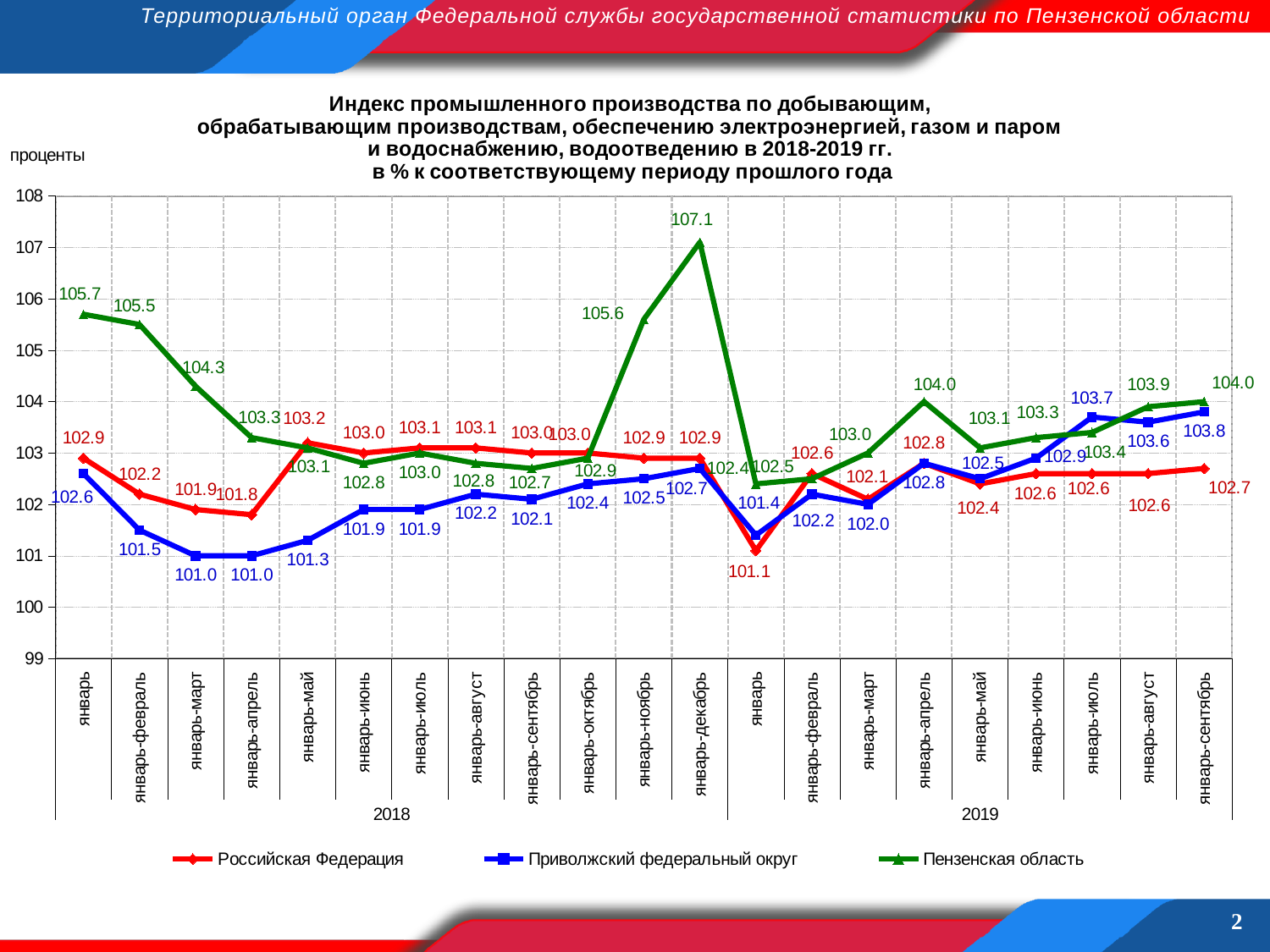
In which period does Пензенская область reach its highest value? январь-декабрь 2018 How many series does the legend list? 3 Is the value for Пензенская область in январь-ноябрь 2018 greater or less than 105? greater What type of chart is shown on the slide? line chart Which colour is used for the Пензенская область line? green What is the value for Пензенская область in январь-декабрь 2018? 107.1 What is the value for Приволжский федеральный округ in январь-сентябрь 2019? 103.8 How many data points are plotted for each series along the x axis? 21 What is the value for Российская Федерация in январь 2019? 101.1 In which period does Российская Федерация have its lowest value? январь 2019 What is the difference between Пензенская область and Российская Федерация in январь 2018? 2.8 Which series has the higher value in январь-июль 2019: Приволжский федеральный округ or Российская Федерация? Приволжский федеральный округ